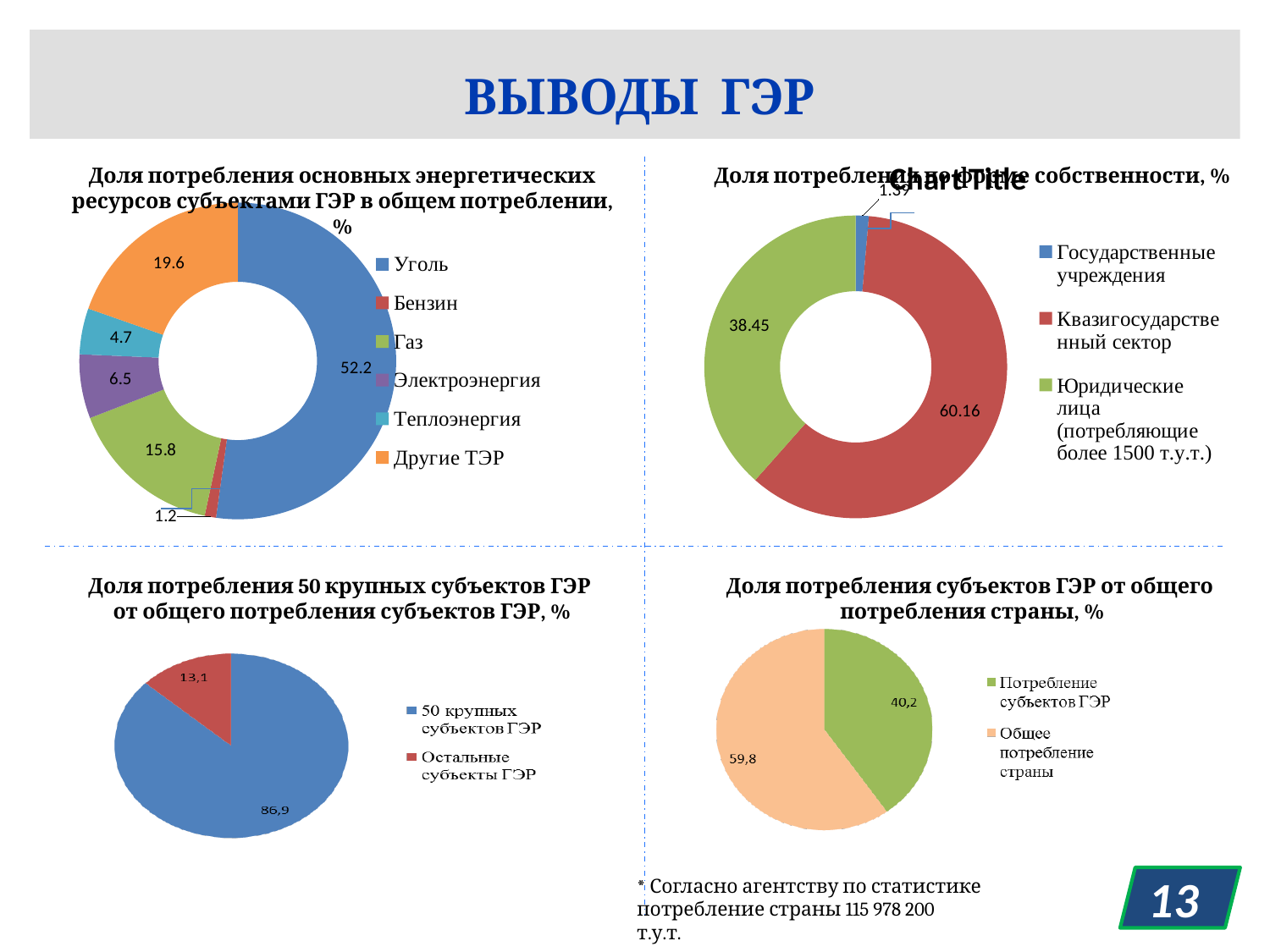
In the top-right chart (Доля потребления по форме собственности, %), what is the value for Квазигосударственный сектор? 60.16 In the top-left chart (Доля потребления основных энергетических ресурсов субъектами ГЭР в общем потреблении, %), what is the difference between the values for Другие ТЭР and Газ? 3.8 In the top-right chart (Доля потребления по форме собственности, %), what is the value for Государственные учреждения? 1.39 In the top-left chart (Доля потребления основных энергетических ресурсов субъектами ГЭР в общем потреблении, %), which is larger: Электроэнергия or Теплоэнергия? Электроэнергия What type of chart is the bottom-left chart (Доля потребления 50 крупных субъектов ГЭР от общего потребления субъектов ГЭР, %)? Pie chart In the top-left chart (Доля потребления основных энергетических ресурсов субъектами ГЭР в общем потреблении, %), which category has the smallest share? Бензин In the bottom-right chart (Доля потребления субъектов ГЭР от общего потребления страны, %), what is the value for Общее потребление страны? 59,8 In the bottom-left chart (Доля потребления 50 крупных субъектов ГЭР от общего потребления субъектов ГЭР, %), what is the value for 50 крупных субъектов ГЭР? 86,9 In the top-left chart (Доля потребления основных энергетических ресурсов субъектами ГЭР в общем потреблении, %), how many categories does the legend list? 6 In the top-left chart (Доля потребления основных энергетических ресурсов субъектами ГЭР в общем потреблении, %), what is the value for Уголь? 52.2 In the bottom-right chart (Доля потребления субъектов ГЭР от общего потребления страны, %), what is the difference between Общее потребление страны and Потребление субъектов ГЭР? 19,6 In the top-right chart (Доля потребления по форме собственности, %), which category has the largest share? Квазигосударственный сектор